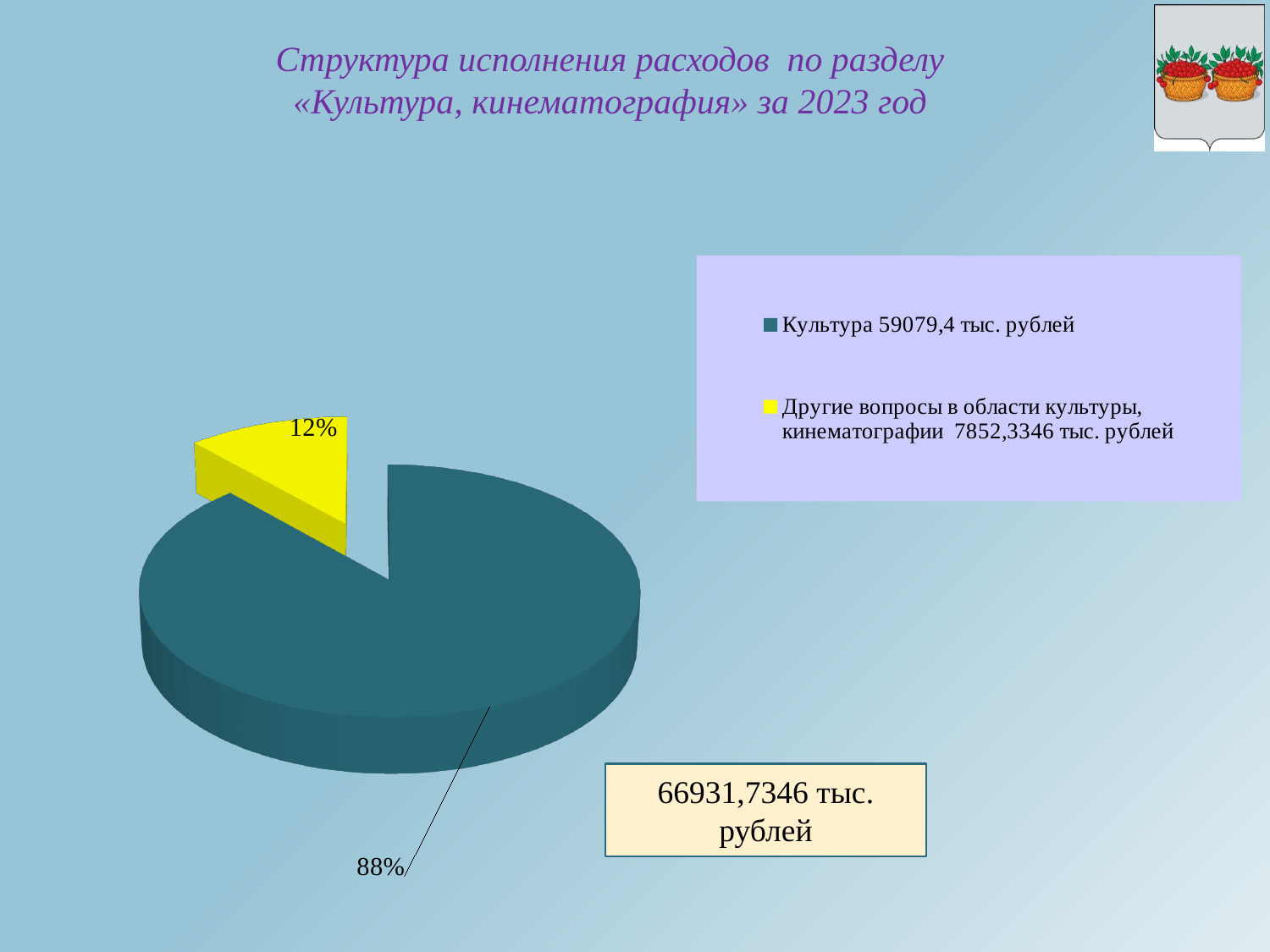
What percentage share does the slice for «Другие вопросы в области культуры, кинематографии» have? 12% How many slices does the pie chart have? 2 What amount in тыс. рублей does the legend give for «Другие вопросы в области культуры, кинематографии»? 7852,3346 тыс. рублей Which slice is the smallest in the pie chart? Другие вопросы в области культуры, кинематографии How many entries does the legend list? 2 What percentage share does the slice for «Культура» have? 88% What colour is the slice for «Другие вопросы в области культуры, кинематографии»? yellow What kind of chart is shown on the slide? pie chart What is the difference in percentage points between the «Культура» slice and the «Другие вопросы в области культуры, кинематографии» slice? 76 What amount in тыс. рублей does the legend give for «Культура»? 59079,4 тыс. рублей Which slice is the largest in the pie chart? Культура Which is larger: the share for «Культура» or the share for «Другие вопросы в области культуры, кинематографии»? Культура